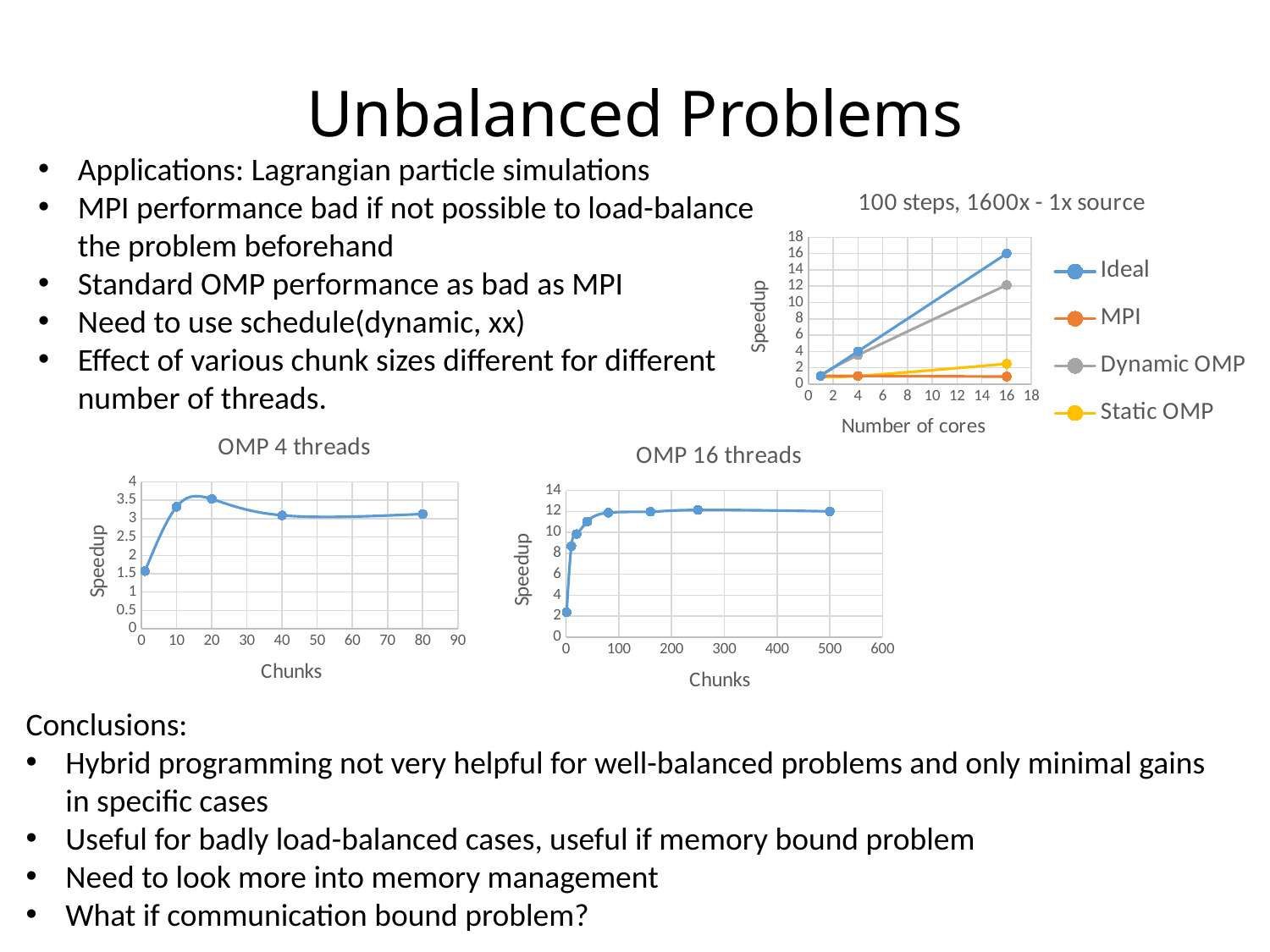
In the 'OMP 16 threads' chart, what is the y-axis label? Speedup In the 'OMP 16 threads' chart, is the speedup at 500 chunks greater or less than 10? greater In the chart titled '100 steps, 1600x - 1x source', how many series does the legend list? 4 In the chart titled '100 steps, 1600x - 1x source', which series is larger at 16 cores, Static OMP or MPI? Static OMP In the 'OMP 4 threads' chart, which is larger, the speedup at 20 chunks or at 40 chunks? 20 chunks In the 'OMP 4 threads' chart, is the speedup at 20 chunks greater or less than 3? greater In the chart titled '100 steps, 1600x - 1x source', is the Dynamic OMP speedup at 16 cores greater or less than 10? greater In the chart titled '100 steps, 1600x - 1x source', which series has the highest speedup at 16 cores? Ideal What kind of chart is the 'OMP 4 threads' chart? line chart In the chart titled '100 steps, 1600x - 1x source', what is the x-axis label? Number of cores